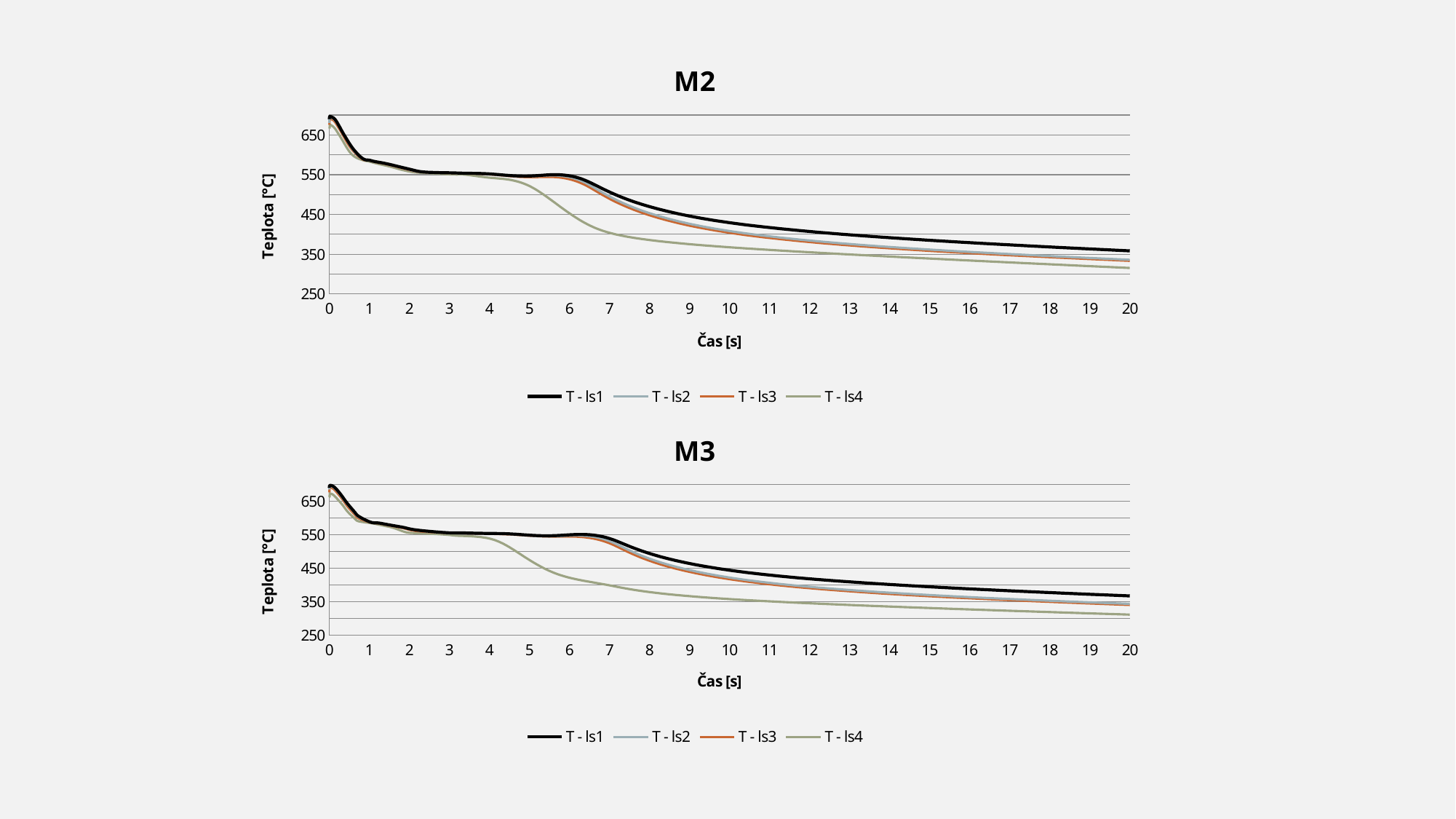
In the M2 chart, at 10 s, which is larger: T - ls1 or T - ls4? T - ls1 How many series does the legend of the M3 chart list? 4 What kind of chart is the chart titled M2? line chart In the M3 chart, is the value of T - ls4 at 20 s greater or less than 350? less What is the label of the y axis on the M3 chart? Teplota [°C] In the M2 chart, do the temperature values rise or fall as time increases along the x axis? fall In the M2 chart, which series has the lowest value at 20 s? T - ls4 What is the label of the x axis on the M2 chart? Čas [s] In the M2 chart, is the value of T - ls1 at 20 s greater or less than 350? greater In the M2 chart, is the value of T - ls4 at 20 s greater or less than 350? less In the M3 chart, which series has the highest value at 20 s? T - ls1